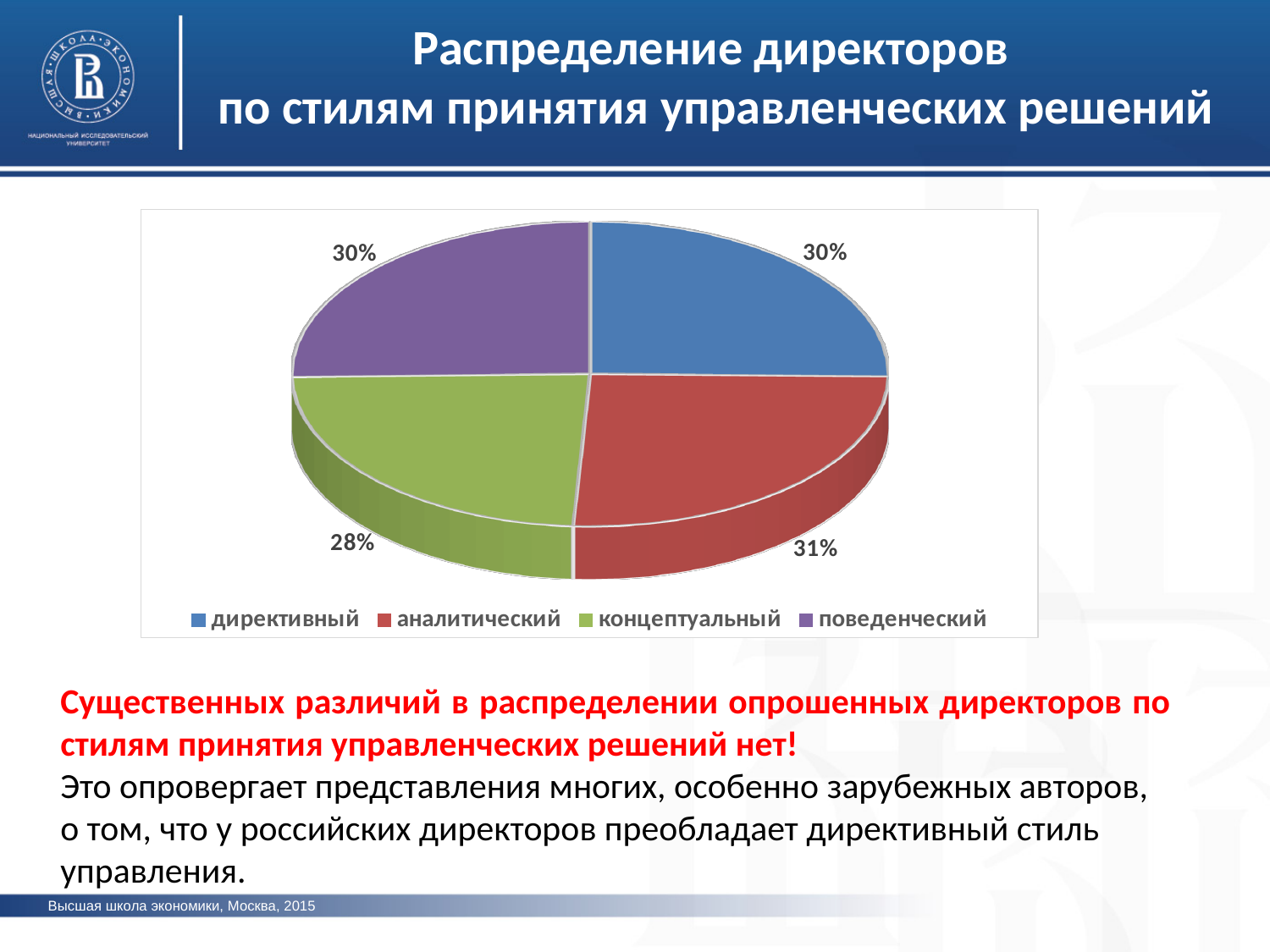
What share of directors has the поведенческий decision-making style? 30% Which decision-making style has the largest share in the pie chart? аналитический How many slices does the pie chart have? 4 Which colour represents the поведенческий style in the pie chart? purple What is the difference in percentage points between the аналитический and концептуальный shares? 3 What share of directors has the концептуальный decision-making style? 28% What kind of chart is shown on the slide? pie chart Which decision-making style has the smallest share in the pie chart? концептуальный What share of directors has the аналитический decision-making style? 31% What share of directors has the директивный decision-making style? 30% Which legend entry is shown in green? концептуальный Which share is larger, аналитический or директивный? аналитический